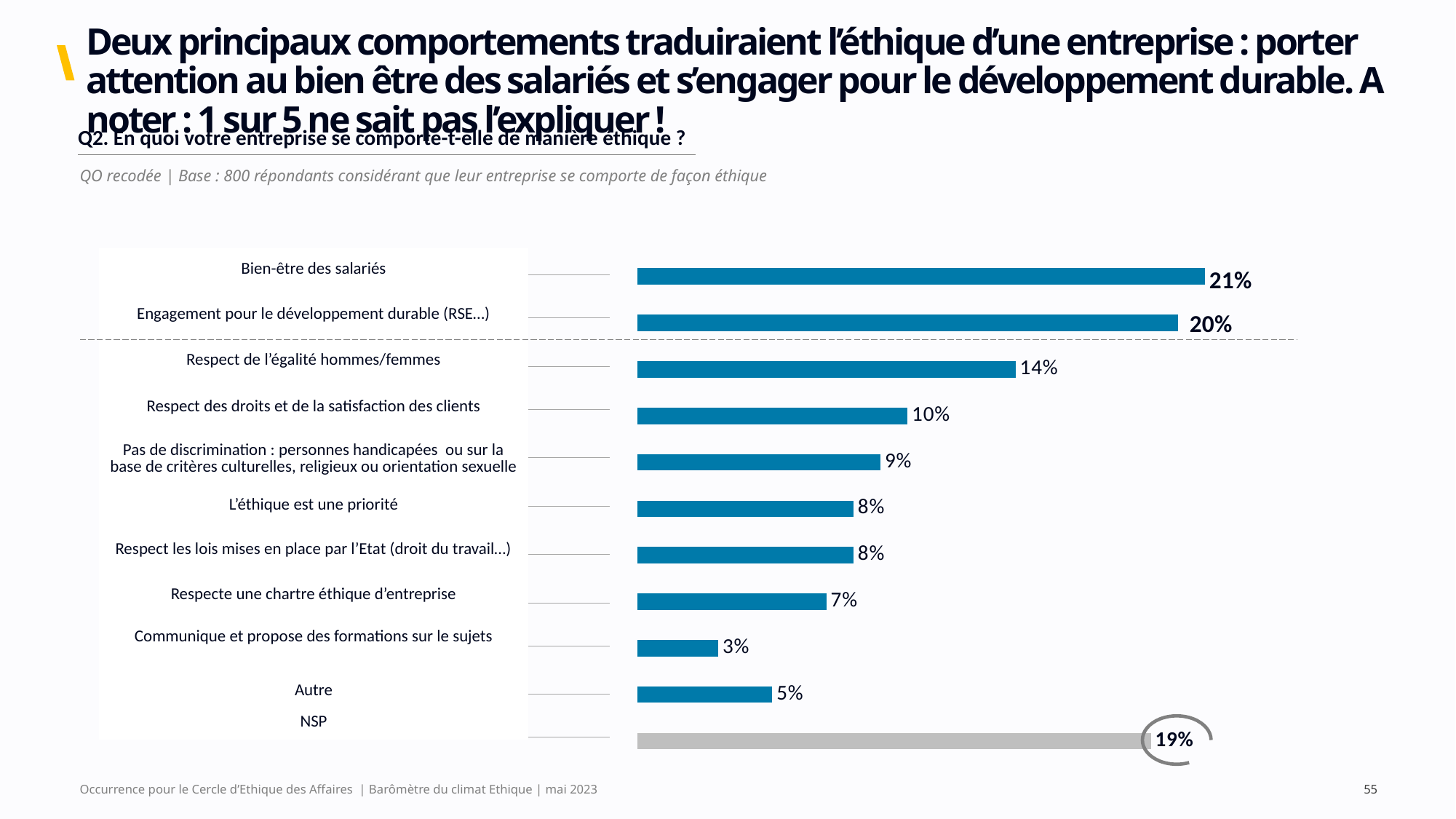
What is the value for "Bien-être des salariés"? 21% What is the value for "NSP"? 19% What is the value for "Autre"? 5% Which category has the highest value? Bien-être des salariés Which is larger: the value for "Respect des droits et de la satisfaction des clients" or the value for "Respecte une chartre éthique d'entreprise"? Respect des droits et de la satisfaction des clients What is the difference between the values for "Bien-être des salariés" and "Respect de l'égalité hommes/femmes"? 7% What is the value for "Respect de l'égalité hommes/femmes"? 14% Which category has the lowest value? Communique et propose des formations sur le sujets What is the value for "Engagement pour le développement durable (RSE…)"? 20% Which bar is shown in grey rather than blue? NSP What type of chart is shown on the slide? bar chart How many categories are shown in the chart? 11